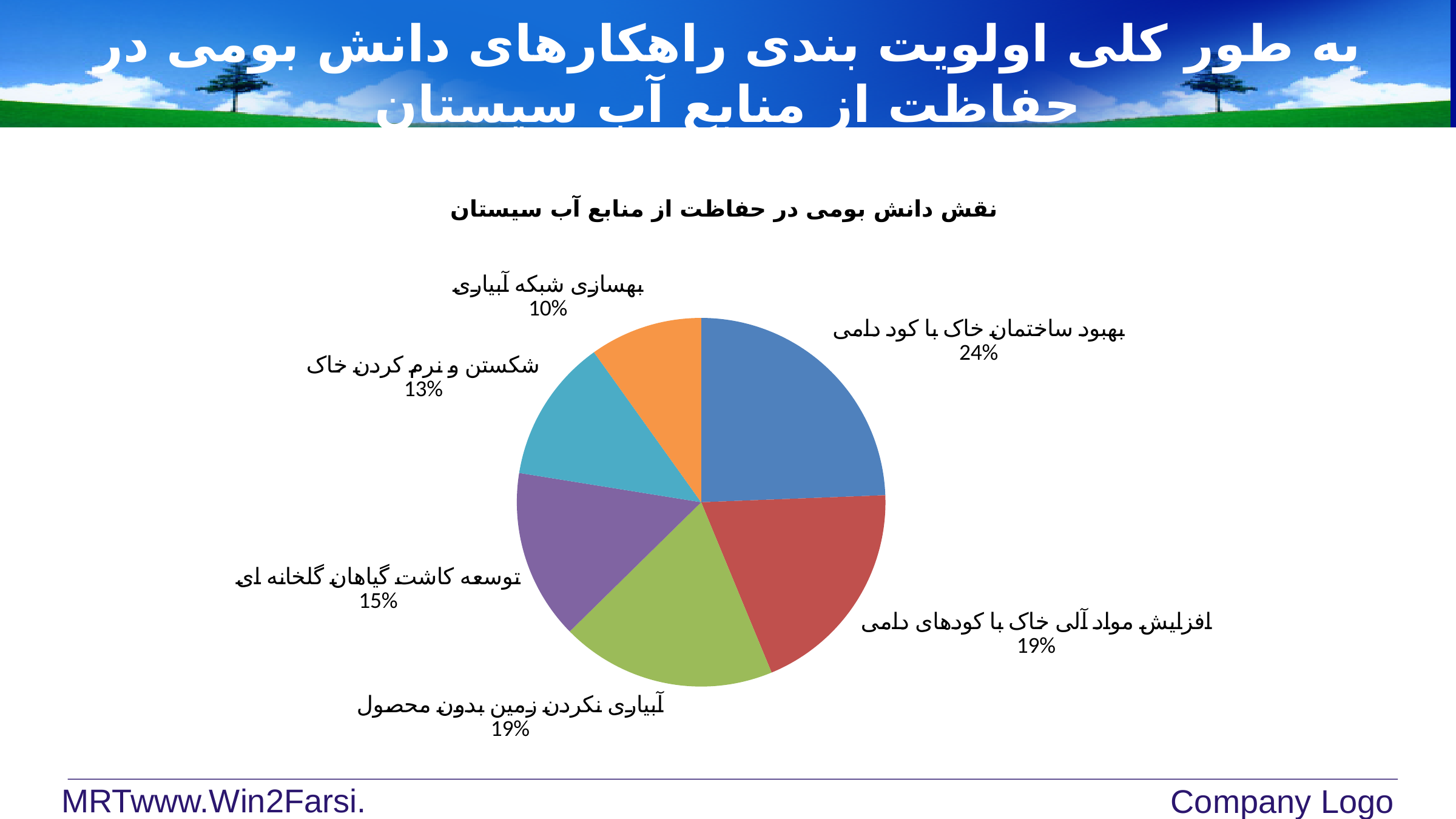
What share of the pie is labelled 'بهبود ساختمان خاک با کود دامی'? 24% What share of the pie is labelled 'توسعه کاشت گیاهان گلخانه ای'? 15% What share of the pie is labelled 'افزایش مواد آلی خاک با کودهای دامی'? 19% Which category has the largest share of the pie? بهبود ساختمان خاک با کود دامی How many slices does the pie chart have? 6 What is the difference in percentage points between 'بهبود ساختمان خاک با کود دامی' and 'بهسازی شبکه آبیاری'? 14 What is the title of the chart? نقش دانش بومی در حفاظت از منابع آب سیستان Which is larger: the share for 'توسعه کاشت گیاهان گلخانه ای' or the share for 'شکستن و نرم کردن خاک'? توسعه کاشت گیاهان گلخانه ای Which category has the smallest share of the pie? بهسازی شبکه آبیاری What kind of chart is shown on the slide? pie chart